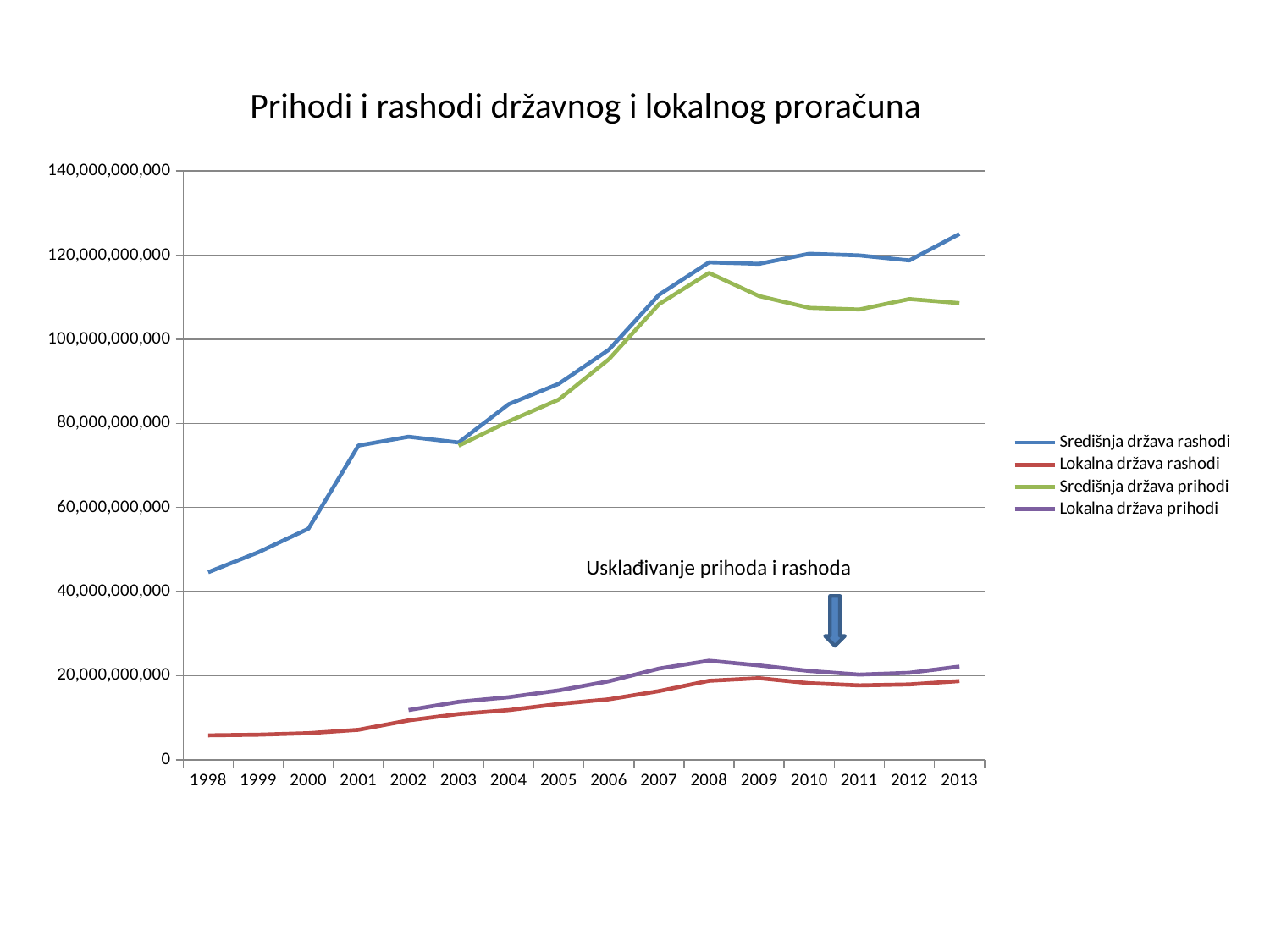
In which year is Središnja država rashodi highest? 2013 How many years are shown on the x axis? 16 What kind of chart is shown on the slide? line chart In which year is Središnja država prihodi highest? 2008 What is the title of the chart? Prihodi i rashodi državnog i lokalnog proračuna In 2013, which is larger: Središnja država rashodi or Središnja država prihodi? Središnja država rashodi Is the value for Središnja država rashodi in 1998 greater or less than 60,000,000,000? less Is the value for Lokalna država rashodi in 1998 greater or less than 20,000,000,000? less Is the value for Lokalna država prihodi in 2008 greater or less than 20,000,000,000? greater Which series is drawn with the blue line? Središnja država rashodi How many series does the legend list? 4